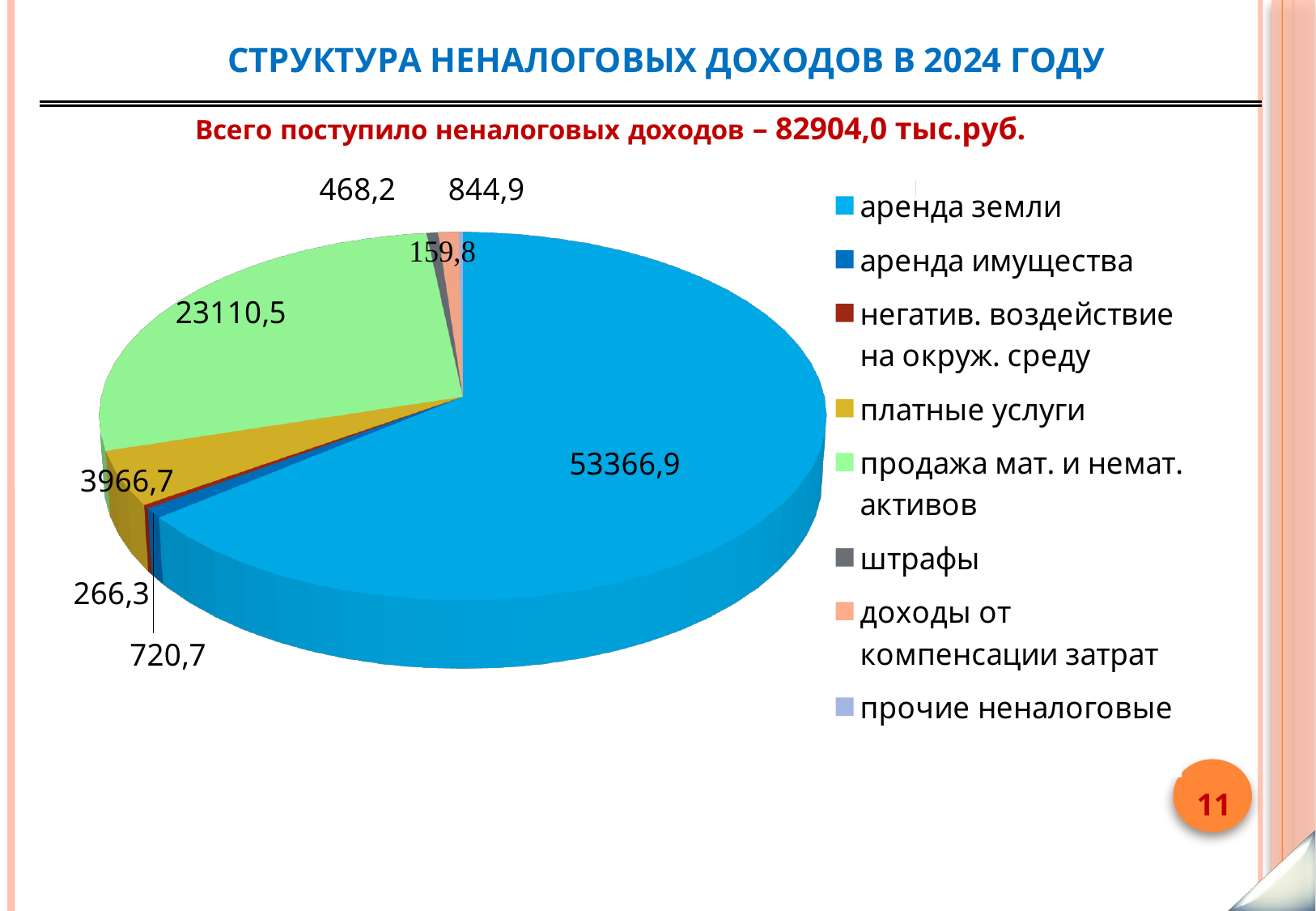
What is the value for штрафы? 468,2 What is the value for продажа мат. и немат. активов? 23110,5 How many categories does the legend list? 8 Which is larger, the value for аренда имущества or the value for негатив. воздействие на окруж. среду? аренда имущества What total of non-tax revenues is stated on the slide? 82904,0 тыс.руб. What kind of chart is shown on the slide? pie chart What is the value for доходы от компенсации затрат? 844,9 What is the difference between the values for аренда земли and продажа мат. и немат. активов? 30256,4 What is the value for аренда земли? 53366,9 Which category has the largest slice of the pie? аренда земли Which category has the smallest slice of the pie? прочие неналоговые What is the value for платные услуги? 3966,7